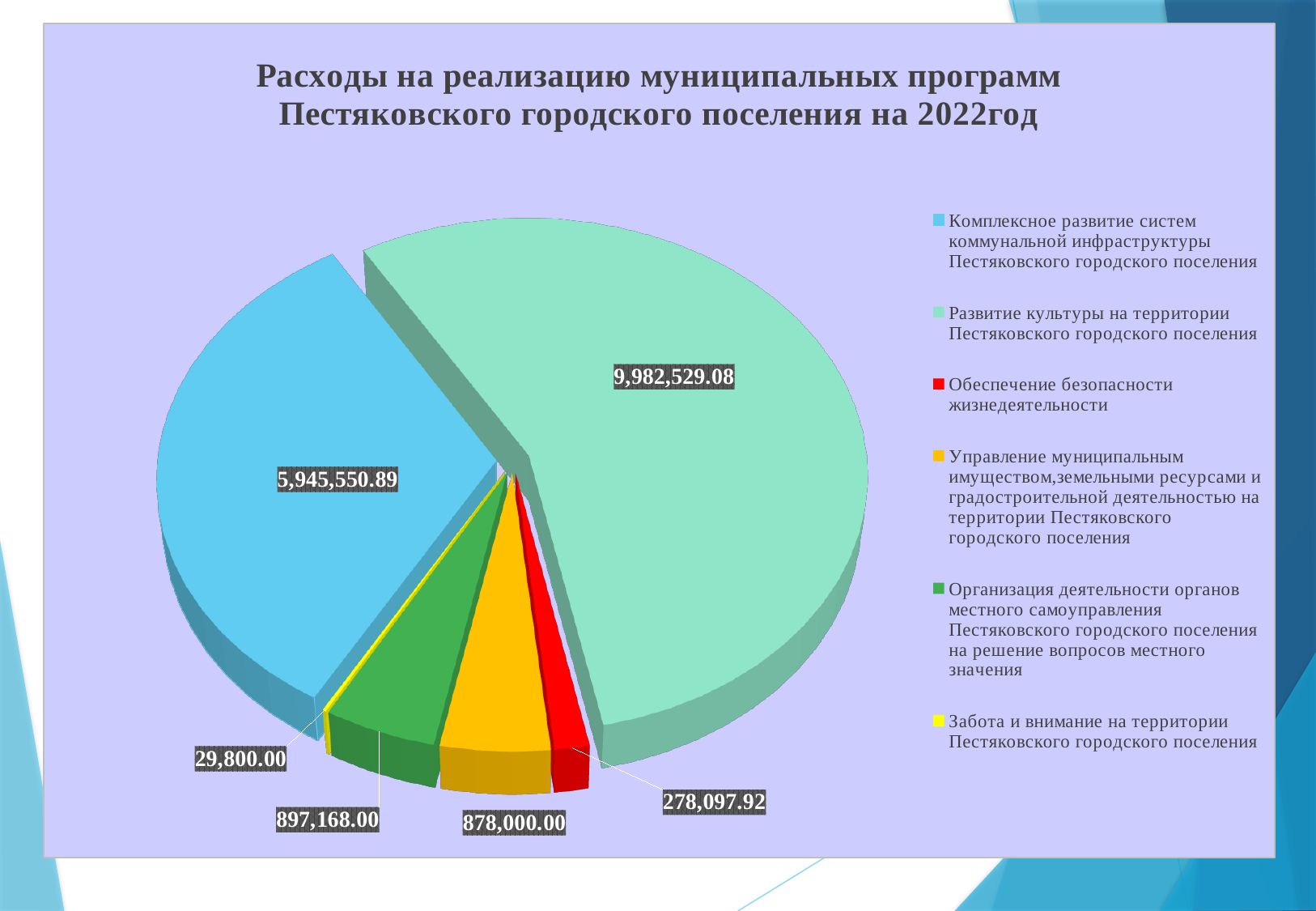
What is the value for Комплексное развитие систем коммунальной инфраструктуры Пестяковского городского поселения? 5,945,550.89 What is the value for Забота и внимание на территории Пестяковского городского поселения? 29,800.00 Which program has the smallest expenditure? Забота и внимание на территории Пестяковского городского поселения What is the value for Обеспечение безопасности жизнедеятельности? 278,097.92 What kind of chart is shown on the slide? Pie chart Which program has the largest expenditure? Развитие культуры на территории Пестяковского городского поселения What is the difference between the values for Развитие культуры and Комплексное развитие систем коммунальной инфраструктуры? 4,036,978.19 What is the value for Развитие культуры на территории Пестяковского городского поселения? 9,982,529.08 How many entries does the legend list? 6 How many slices does the pie chart have? 6 Which is larger: the value for Организация деятельности органов местного самоуправления or the value for Управление муниципальным имуществом? Организация деятельности органов местного самоуправления What is the title of the chart? Расходы на реализацию муниципальных программ Пестяковского городского поселения на 2022год